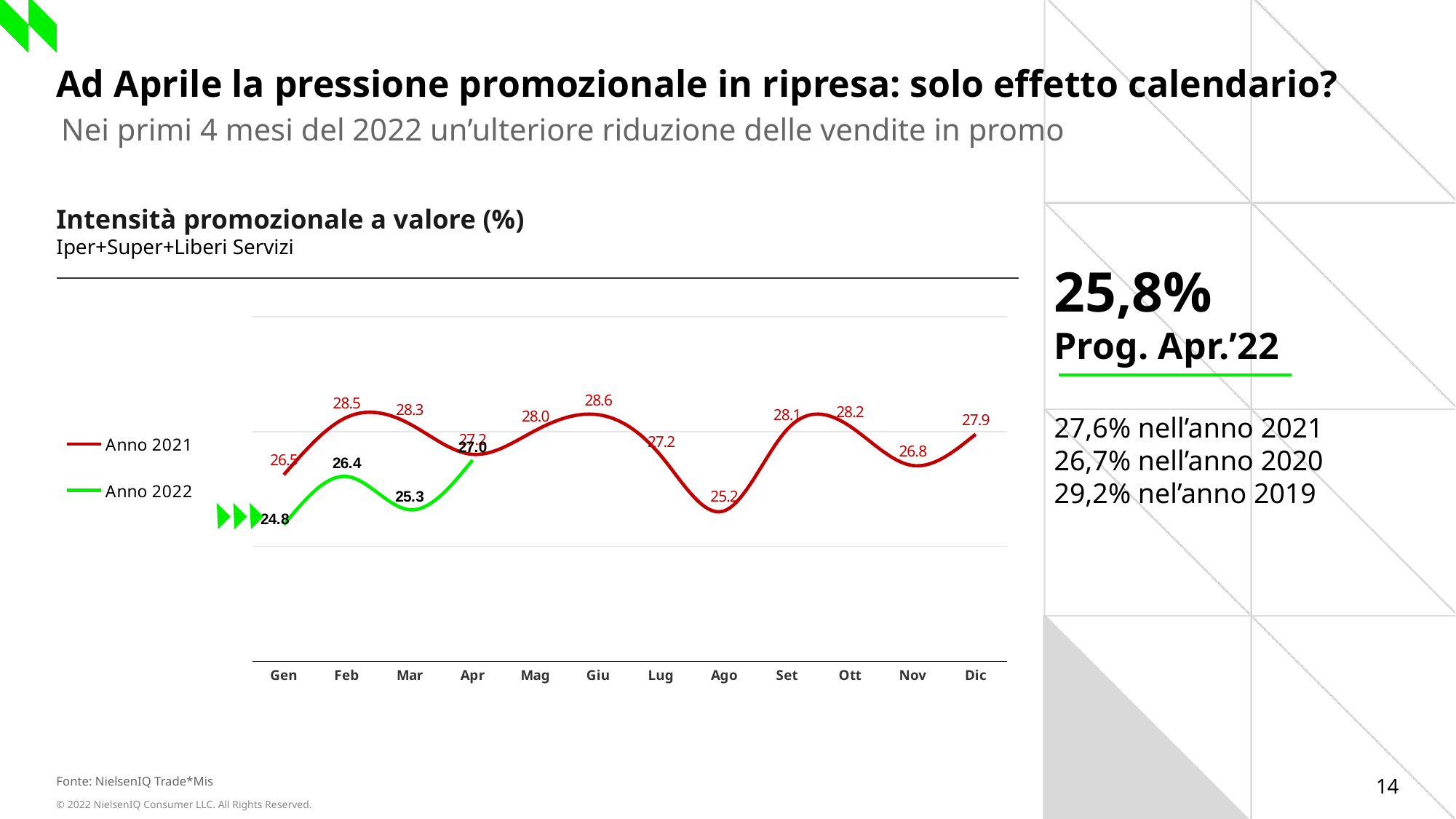
What is the value for Anno 2022 in Gen? 24.8 What is the value for Anno 2021 in Giu? 28.6 In which month is the Anno 2021 value lowest? Ago How many data points are plotted for Anno 2022? 4 Does the Anno 2021 line rise or fall from Giu to Ago? fall What kind of chart is shown on the slide? line chart How many months are shown on the x axis? 12 In Mar, which series has the larger value, Anno 2021 or Anno 2022? Anno 2021 In which month is the Anno 2021 value highest? Giu How many series does the chart legend list? 2 What is the difference between the Anno 2021 and Anno 2022 values in Feb? 2.1 What is the value for Anno 2021 in Dic? 27.9